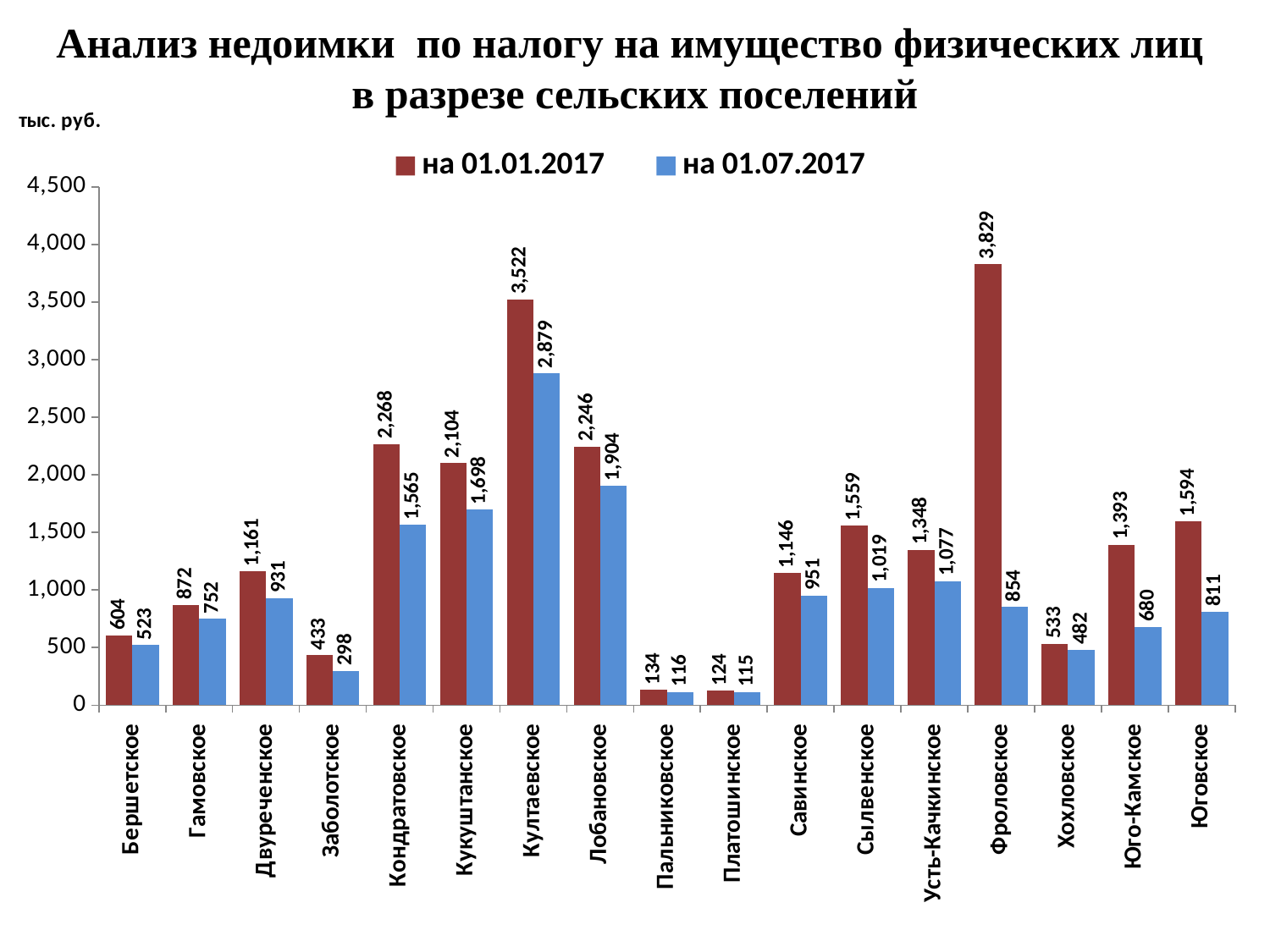
How many settlements are shown on the x axis? 17 Which settlement has the highest value in the series 'на 01.01.2017'? Фроловское What is the value for Фроловское in the series 'на 01.07.2017'? 854 Which is larger: the 'на 01.01.2017' value for Кондратовское or for Лобановское? Кондратовское Which settlement has the lowest value in the series 'на 01.01.2017'? Платошинское Which settlement has the highest value in the series 'на 01.07.2017'? Култаевское What unit is indicated in the top-left corner of the chart? тыс. руб. How many series does the legend list? 2 What is the value for Култаевское in the series 'на 01.01.2017'? 3,522 What is the difference between the 'на 01.01.2017' and 'на 01.07.2017' values for Фроловское? 2,975 What is the value for Заболотское in the series 'на 01.07.2017'? 298 What kind of chart is shown on the slide? Bar chart